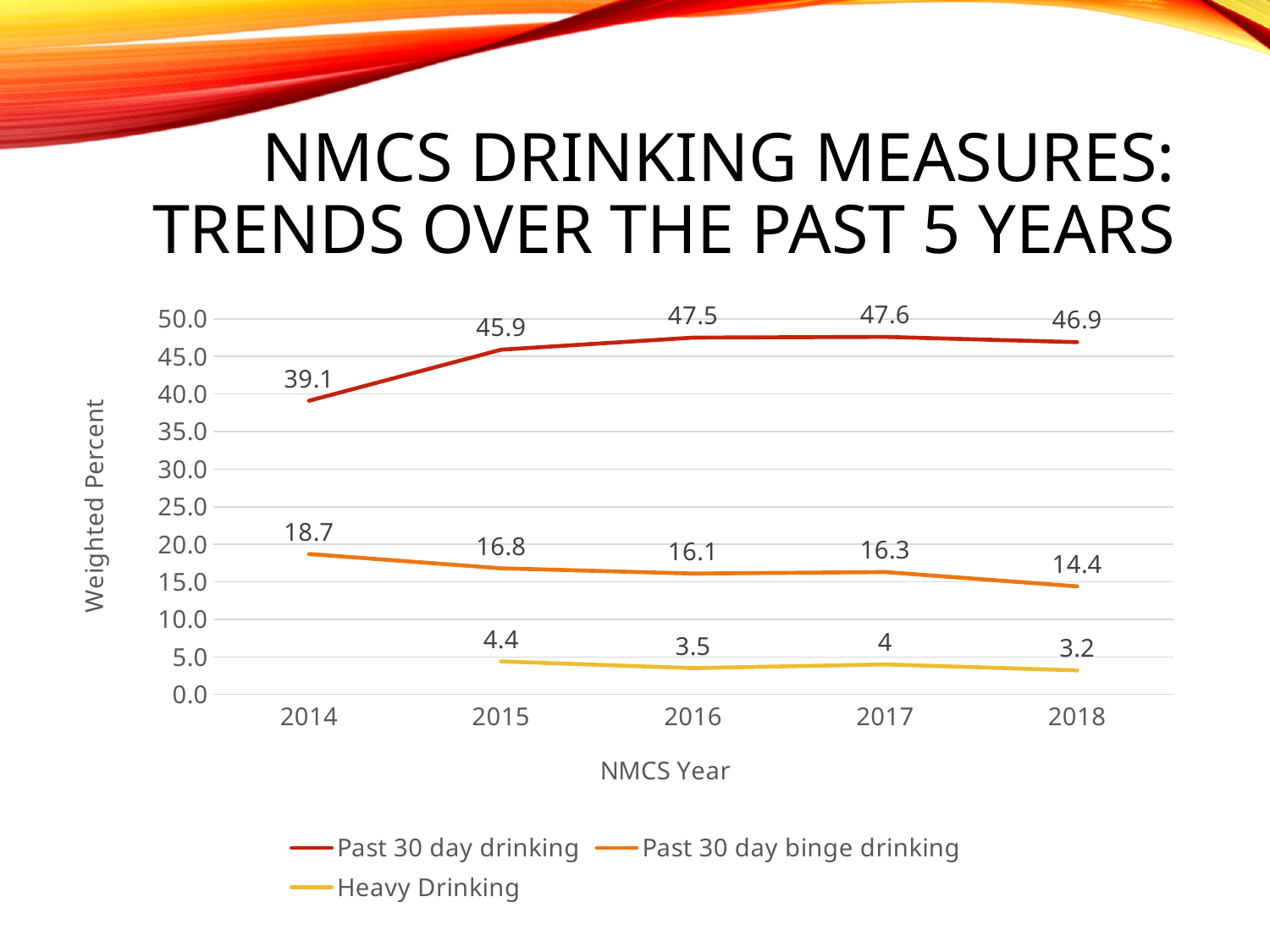
What is the label of the y axis? Weighted Percent What kind of chart is shown on the slide? line chart What is the value for Heavy Drinking in 2016? 3.5 Which is larger: Heavy Drinking in 2015 or Heavy Drinking in 2018? 2015 What is the difference between Past 30 day drinking in 2015 and in 2014? 6.8 In which year is Past 30 day binge drinking lowest? 2018 How many years are shown on the x axis? 5 What is the value for Past 30 day drinking in 2014? 39.1 In which year is Past 30 day drinking highest? 2017 What is the value for Past 30 day binge drinking in 2018? 14.4 Does Past 30 day binge drinking generally rise or fall from 2014 to 2018? fall How many series does the legend list? 3